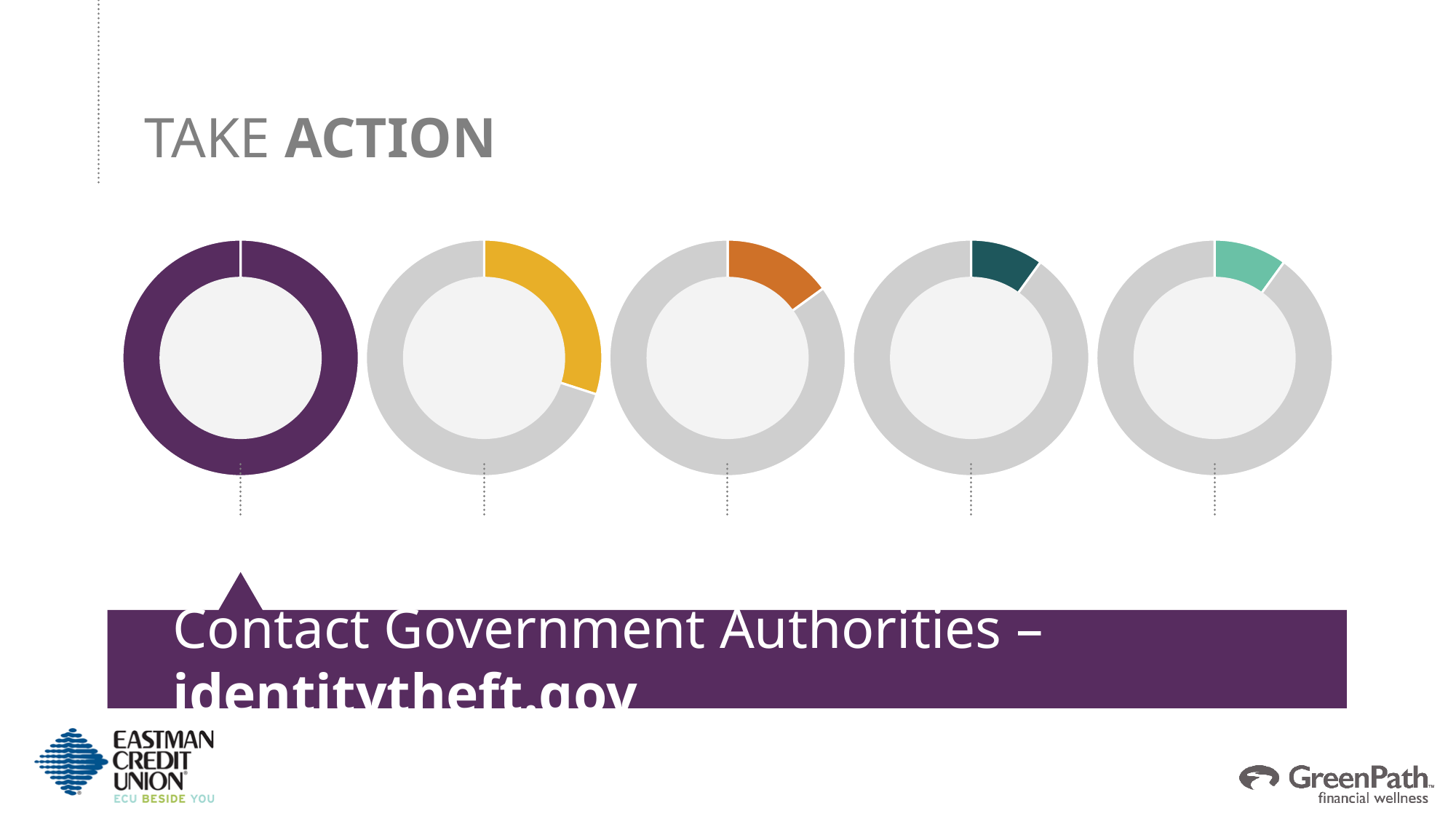
What is the title shown at the top of the slide above the donut charts? TAKE ACTION Is the coloured portion of the second (yellow) donut chart larger or smaller than that of the third (orange) donut chart? Larger Which donut chart has the largest coloured portion? The first (leftmost) chart What colour is the fully filled ring of the first donut chart? Purple Is the coloured portion of the first (purple) donut chart larger or smaller than that of the second (yellow) donut chart? Larger How many donut charts are shown on the slide? 5 What kind of chart is used for the five graphics in the middle of the slide? Pie (donut) chart